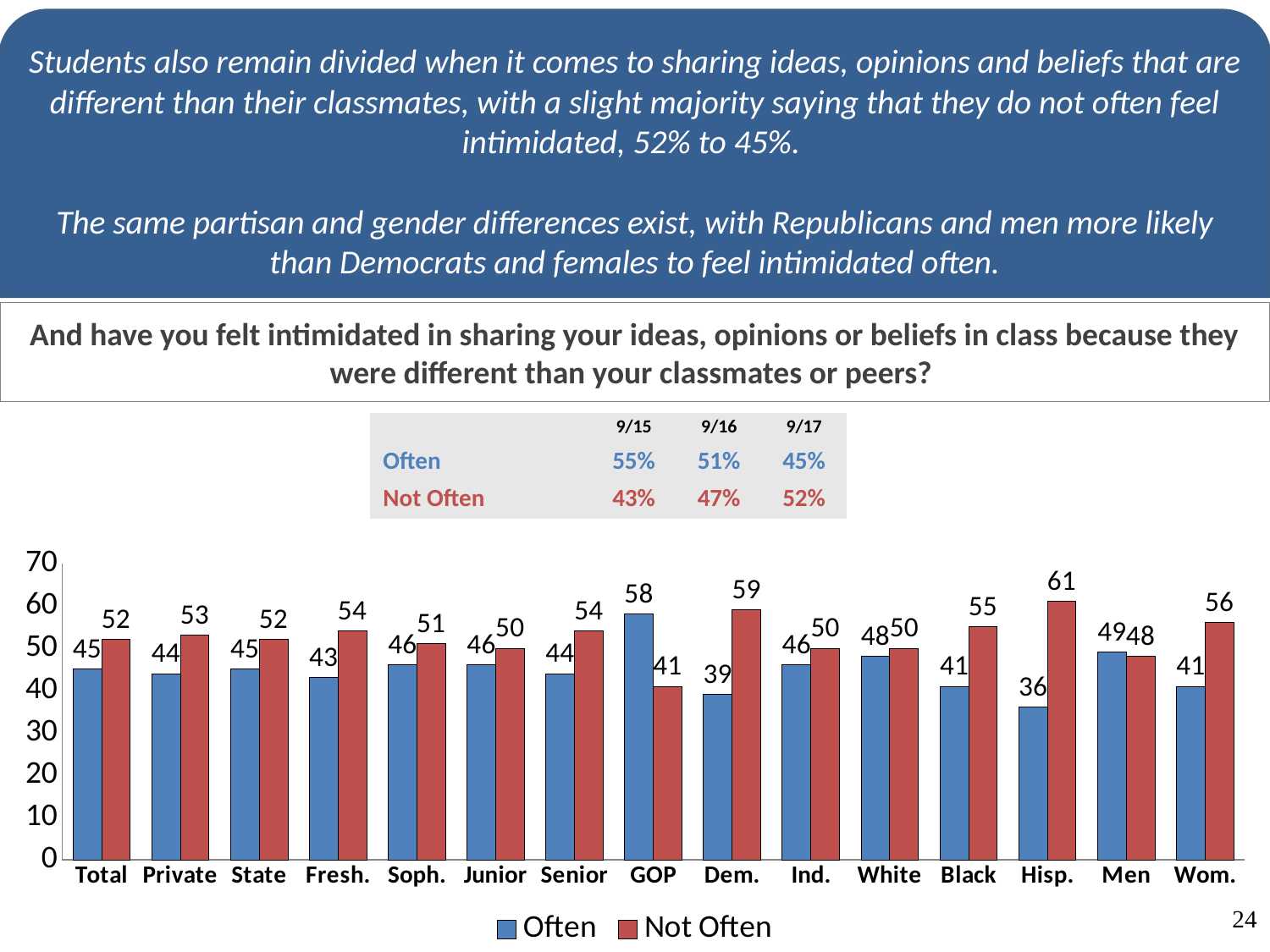
What colour are the Not Often bars in the chart? red What is the difference between the Not Often and Often values for Dem.? 20 What kind of chart is shown on the slide? bar chart Which category has the lowest Often value? Hisp. Is the Often value for Black greater or less than 50? less How many series does the chart legend list? 2 What is the value of the Often series for GOP? 58 Which category has the highest Not Often value? Hisp. What is the value of the Often series for Men? 49 How many categories are shown on the x axis of the chart? 15 What is the value of the Not Often series for Hisp.? 61 Which is larger for Men, the Often value or the Not Often value? Often